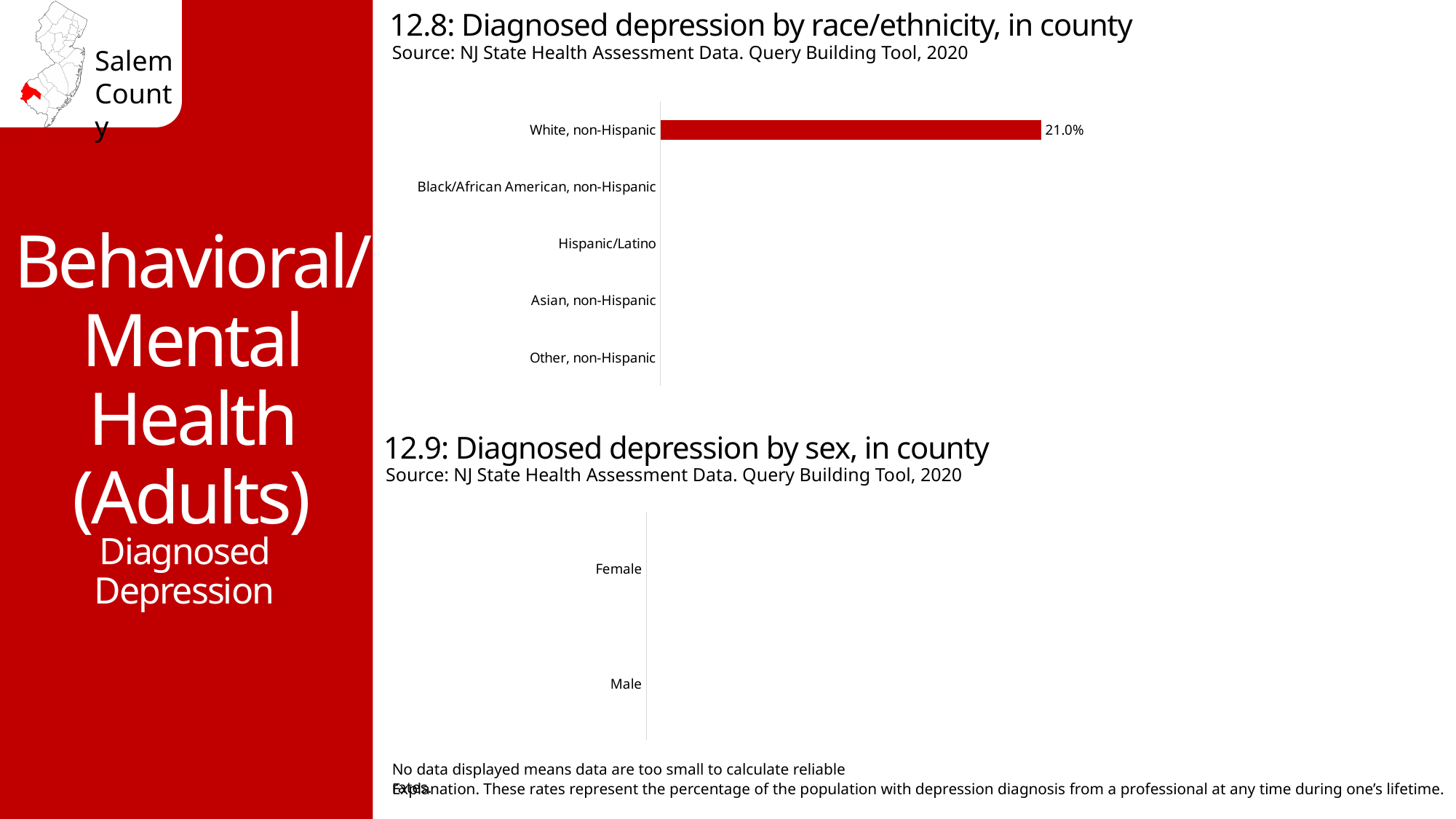
How many categories are listed on the y axis of the chart '12.9: Diagnosed depression by sex, in county'? 2 How many categories are listed on the y axis of the chart '12.8: Diagnosed depression by race/ethnicity, in county'? 5 In the chart '12.8: Diagnosed depression by race/ethnicity, in county', how many categories have a bar displayed? 1 In the chart '12.8: Diagnosed depression by race/ethnicity, in county', which category has the highest value? White, non-Hispanic What kind of chart is '12.8: Diagnosed depression by race/ethnicity, in county'? Bar chart What is the source cited for the chart '12.8: Diagnosed depression by race/ethnicity, in county'? NJ State Health Assessment Data. Query Building Tool, 2020 In the chart '12.8: Diagnosed depression by race/ethnicity, in county', is the value for White, non-Hispanic greater or less than 20%? greater In the chart '12.8: Diagnosed depression by race/ethnicity, in county', what is the value for White, non-Hispanic? 21.0% In the chart '12.8: Diagnosed depression by race/ethnicity, in county', which category is listed last on the y axis? Other, non-Hispanic